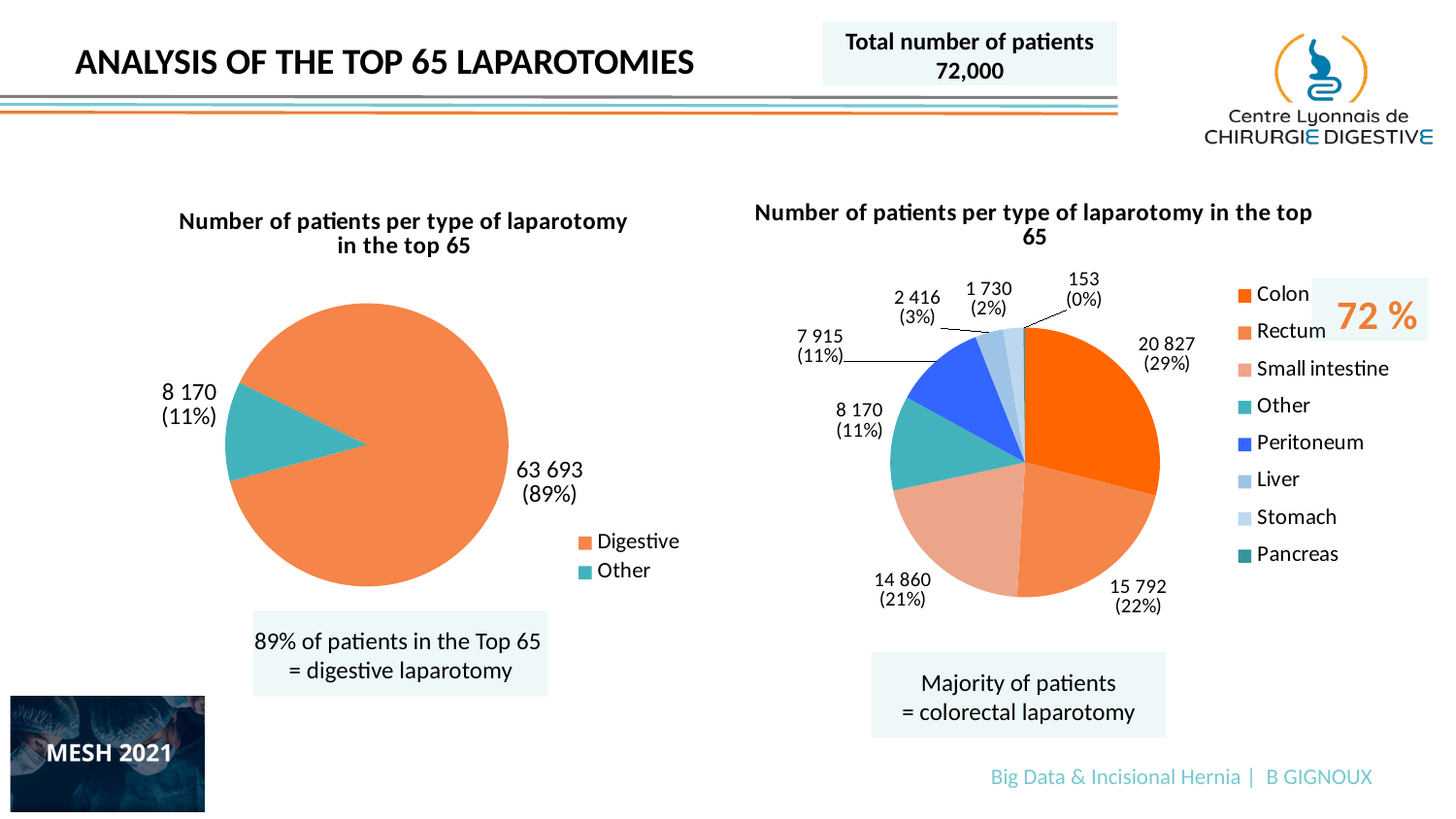
On the right pie chart, which category has the highest number of patients? Colon What type of chart is the left chart on the slide? pie chart How many entries does the legend of the right pie chart list? 8 On the right pie chart, how many patients are in the Stomach category? 1 730 On the left pie chart, what share of the pie does the Other slice represent? 11% On the right pie chart, how many patients are in the Colon category? 20 827 What is the title of the left pie chart? Number of patients per type of laparotomy in the top 65 On the right pie chart, which category has the lowest number of patients? Pancreas On the right pie chart, which has more patients, Small intestine or Peritoneum? Small intestine On the right pie chart, what is the difference in patients between Colon and Rectum? 5 035 On the right pie chart, what share of the pie does the Liver slice represent? 3% On the left pie chart, how many patients are in the Digestive category? 63 693